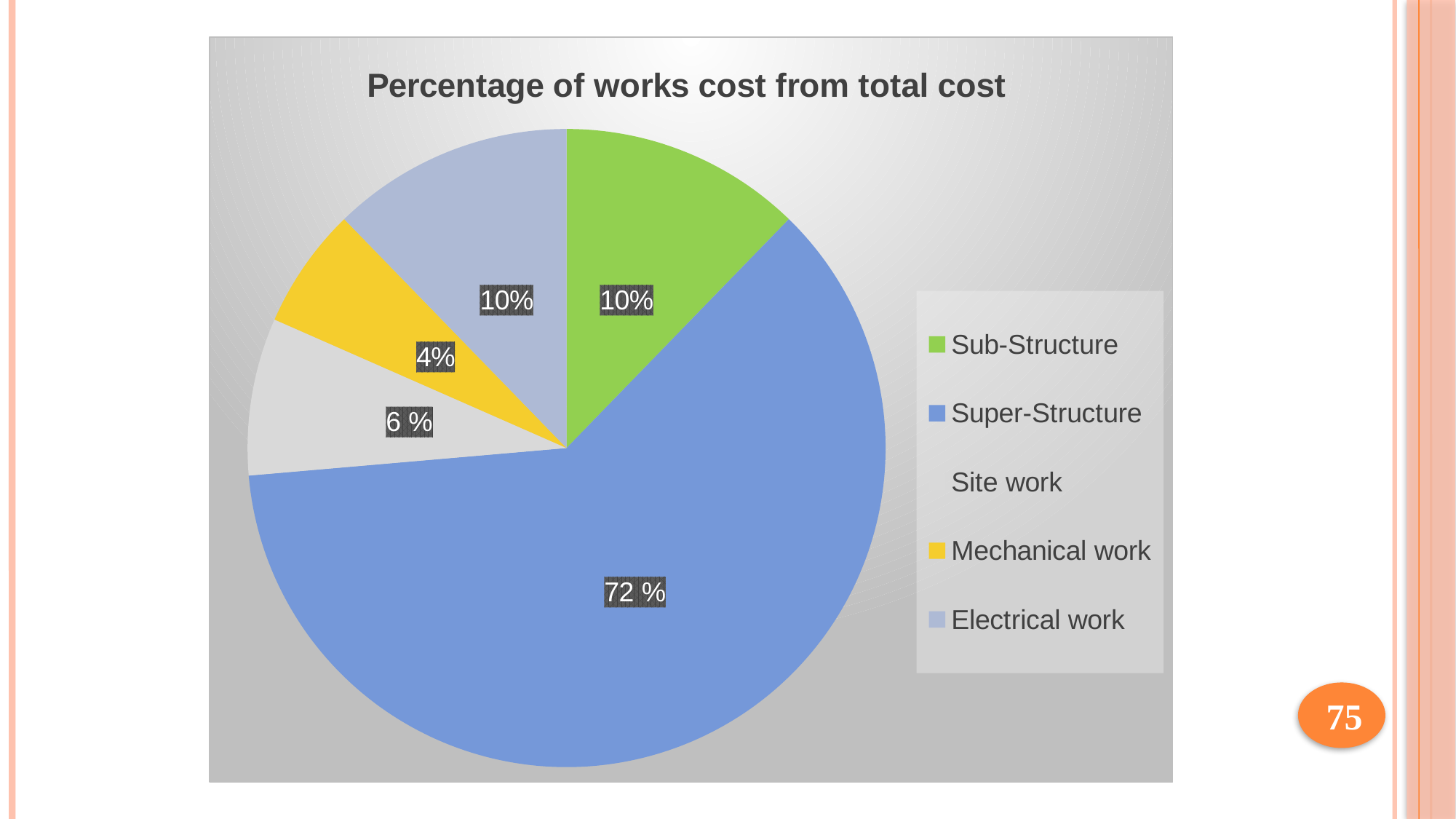
Which is larger, the share for Site work or the share for Mechanical work? Site work How many categories does the pie chart show? 5 What type of chart is shown on the slide? Pie chart What is the title of the chart? Percentage of works cost from total cost What percentage of the total cost is Super-Structure? 72 % What percentage of the total cost is Sub-Structure? 10% What is the difference in percentage points between Super-Structure and Site work? 66 Which category is shown in yellow in the legend? Mechanical work Which category has the smallest share of the total cost? Mechanical work What percentage of the total cost is Site work? 6 % Which category has the largest share of the total cost? Super-Structure What percentage of the total cost is Mechanical work? 4%